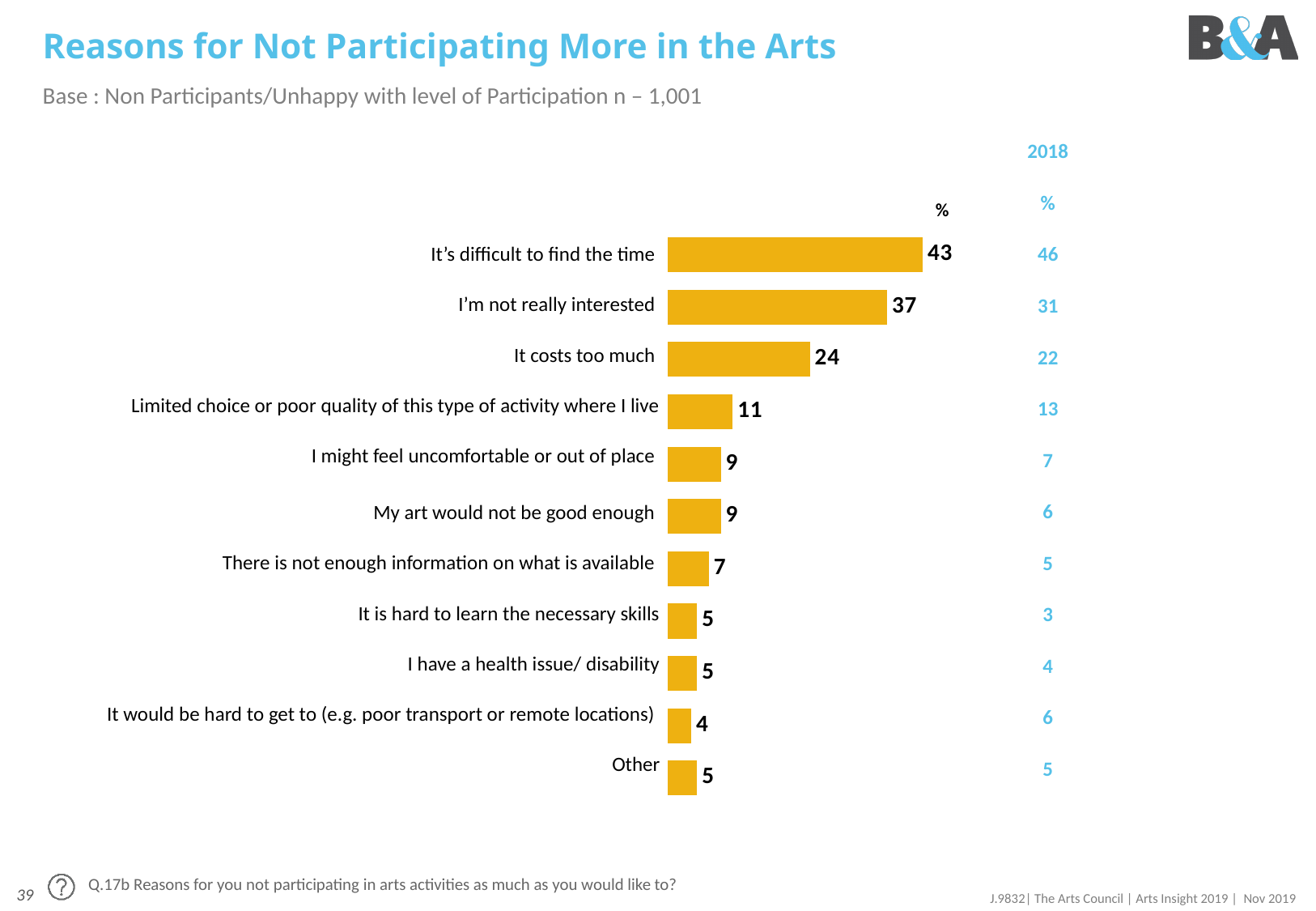
What is the title of the chart on the slide? Reasons for Not Participating More in the Arts Which category has the lowest value? It would be hard to get to (e.g. poor transport or remote locations) What is the value for "It's difficult to find the time"? 43 Which category has the highest value? It's difficult to find the time How many categories are shown in the chart? 11 What is the difference between the values for "It's difficult to find the time" and "I'm not really interested"? 6 What is the difference between the values for "It costs too much" and "Limited choice or poor quality of this type of activity where I live"? 13 What is the value for "It costs too much"? 24 What is the value for "Limited choice or poor quality of this type of activity where I live"? 11 What is the value for "It would be hard to get to (e.g. poor transport or remote locations)"? 4 Which is larger, the value for "I'm not really interested" or the value for "It costs too much"? I'm not really interested What kind of chart is shown on the slide? Bar chart